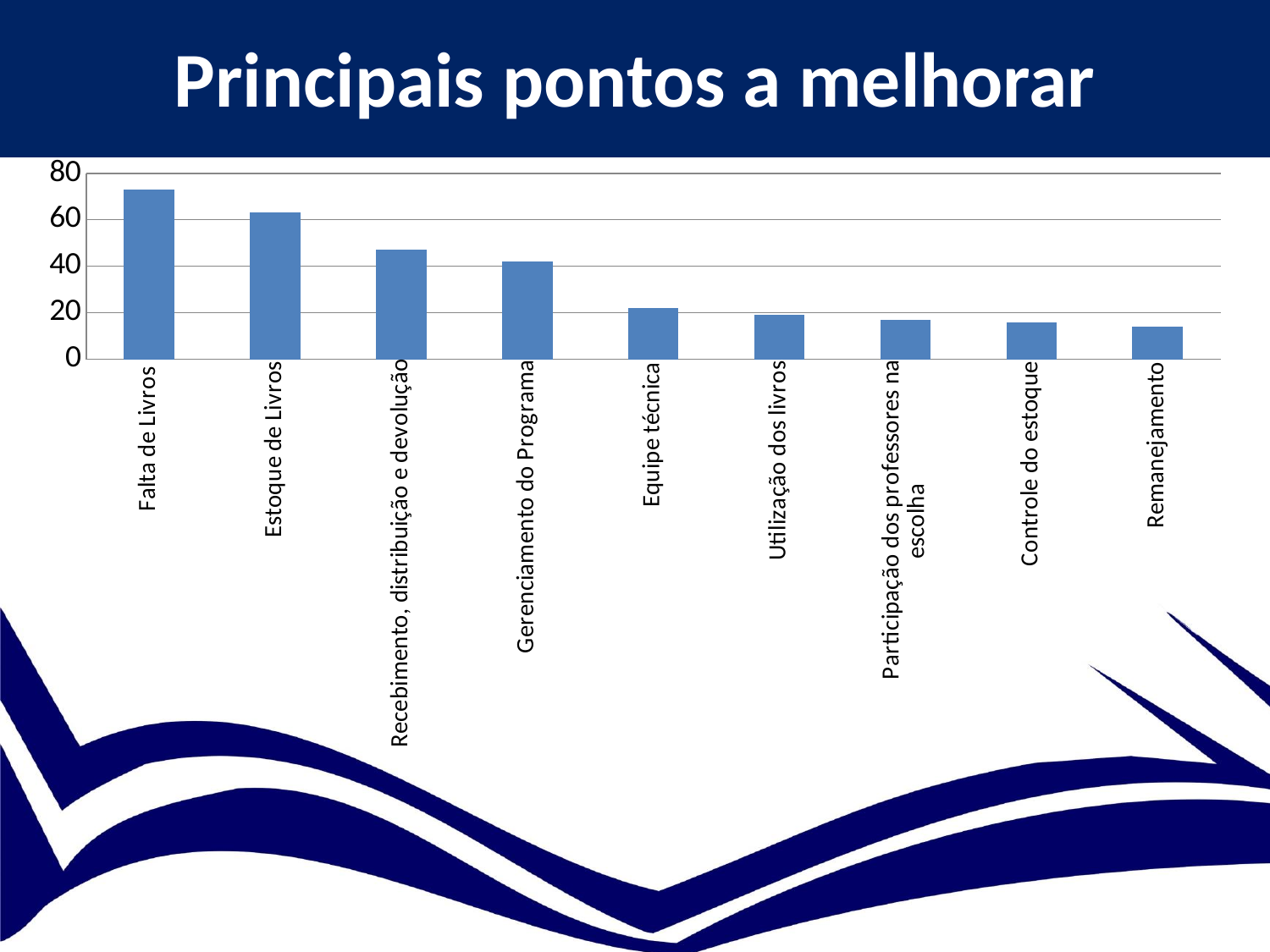
Do the values rise or fall from left to right along the x axis? fall Which category has the lowest value? Remanejamento Is the value for Estoque de Livros greater or less than 60? greater Which is larger, the value for Estoque de Livros or the value for Gerenciamento do Programa? Estoque de Livros How many categories are plotted in the chart? 9 Which is larger, the value for Recebimento, distribuição e devolução or the value for Utilização dos livros? Recebimento, distribuição e devolução What is the title of the slide containing the chart? Principais pontos a melhorar Is the value for Falta de Livros greater or less than 60? greater Which category has the highest value? Falta de Livros What kind of chart is shown on the slide? bar chart Is the value for Equipe técnica greater or less than 40? less